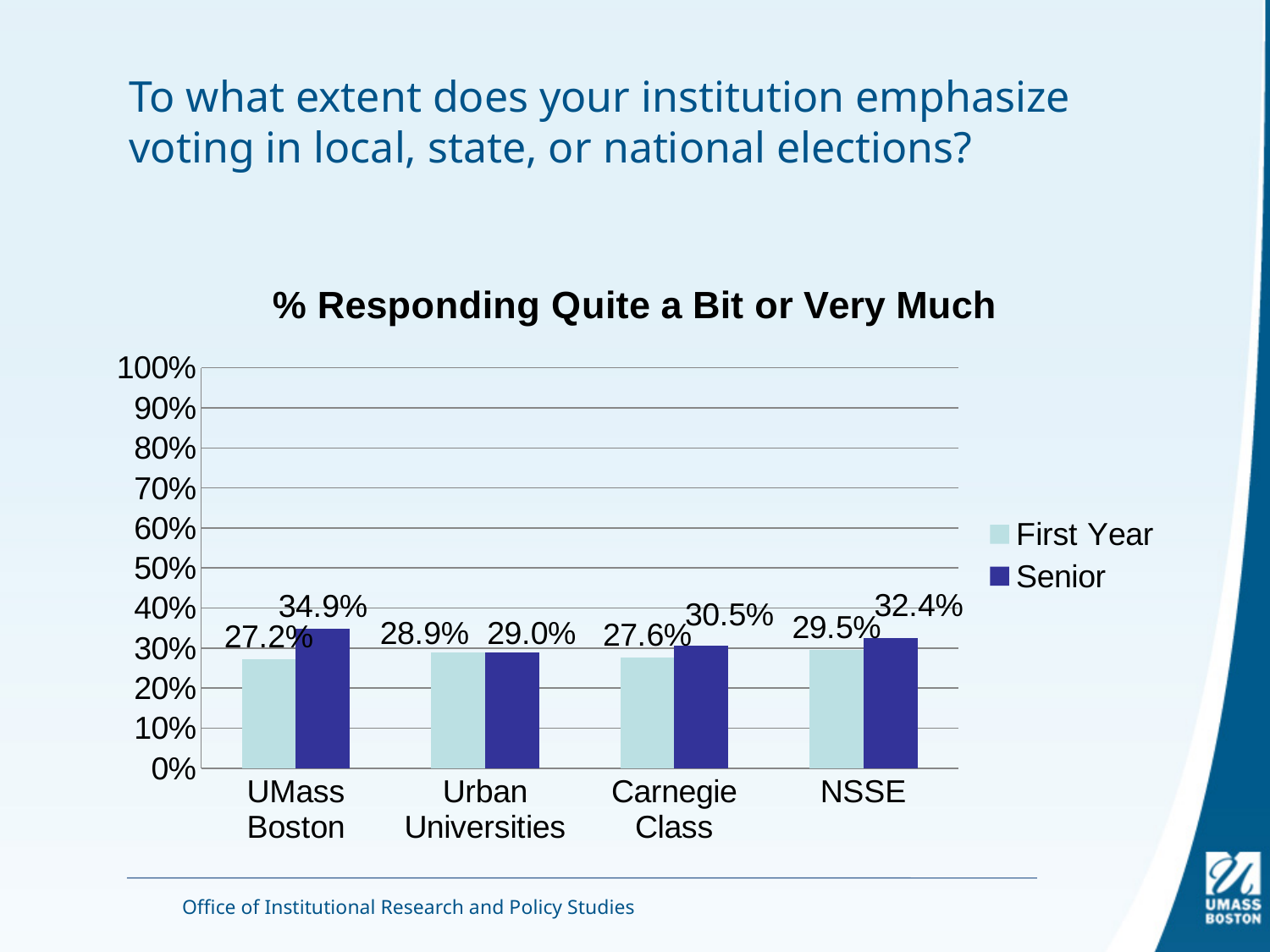
How many categories are shown on the x axis? 4 Which category has the lowest First Year value? UMass Boston Which is larger for NSSE, the First Year value or the Senior value? Senior Is the Senior value for Urban Universities greater or less than 40%? less What is the Senior value for UMass Boston? 34.9% What is the Senior value for Carnegie Class? 30.5% What is the First Year value for UMass Boston? 27.2% How many series does the legend list? 2 Which category has the highest Senior value? UMass Boston What is the difference between the Senior and First Year values for UMass Boston? 7.7% What kind of chart is shown on the slide? bar chart What is the First Year value for NSSE? 29.5%